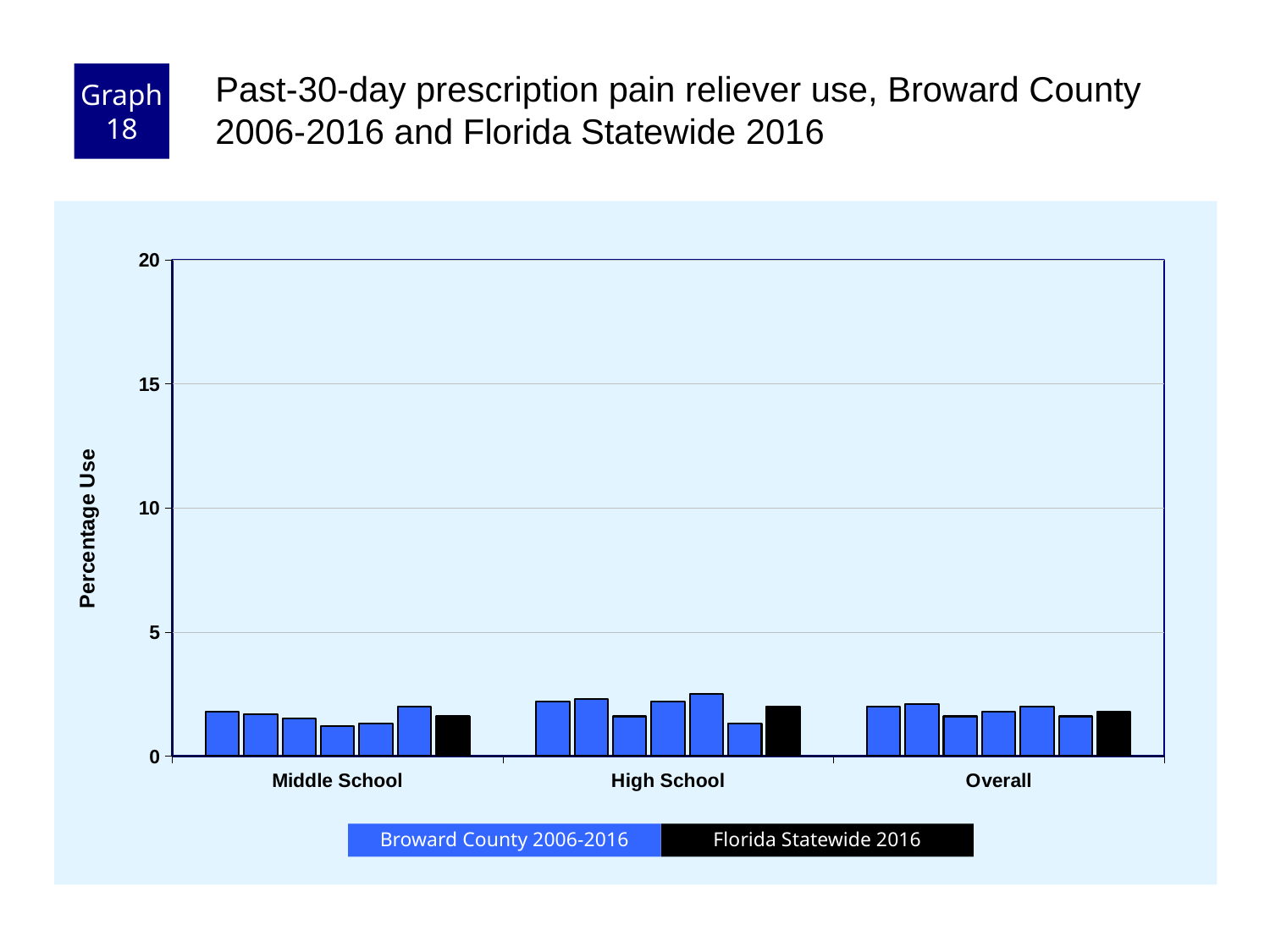
How many series does the legend list? 2 Is the highest Broward County 2006-2016 bar for Overall greater or less than 5? less What is the maximum value shown on the y axis? 20 Is the Florida Statewide 2016 value for Middle School greater or less than 5? less How many school-level categories are shown on the x axis? 3 What is the title of the chart? Past-30-day prescription pain reliever use, Broward County 2006-2016 and Florida Statewide 2016 Are any of the Broward County 2006-2016 bars for High School greater or less than 5? less What is the label on the y axis? Percentage Use What kind of chart is shown on the slide? bar chart